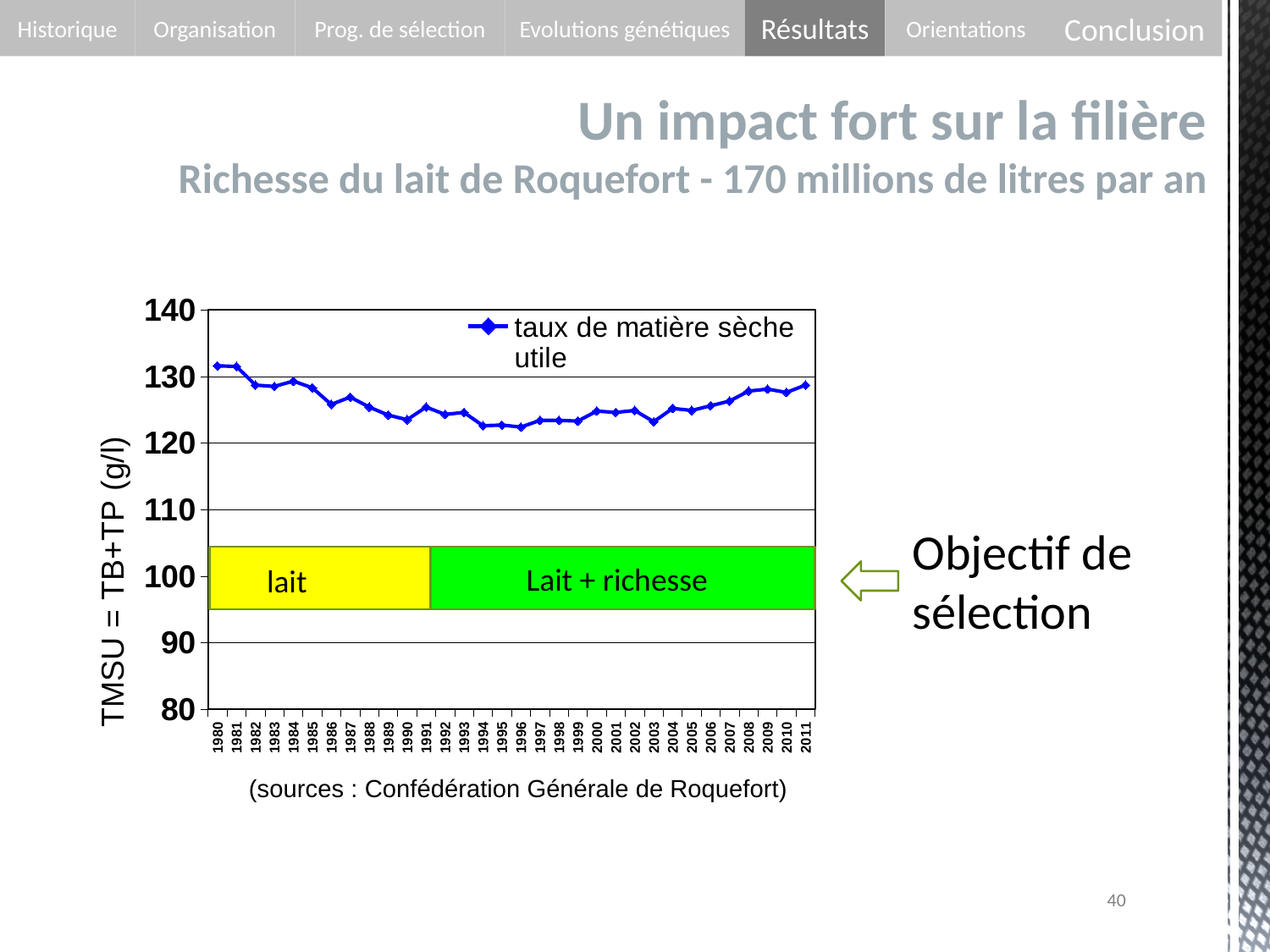
What is the name of the series shown in the chart legend? taux de matière sèche utile Do the values rise or fall between 1980 and 1994? fall Is the value for 1980 greater or less than 130? greater What is the label of the y axis of the chart? TMSU = TB+TP (g/l) Which year has the larger value, 1996 or 2011? 2011 What kind of chart is shown on the slide? line chart Is the value for 1995 greater or less than 120? greater How many years are plotted along the x axis of the chart? 32 How many series does the chart legend list? 1 Which year has the larger value, 1980 or 1994? 1980 Is the value for 2011 greater or less than 130? less